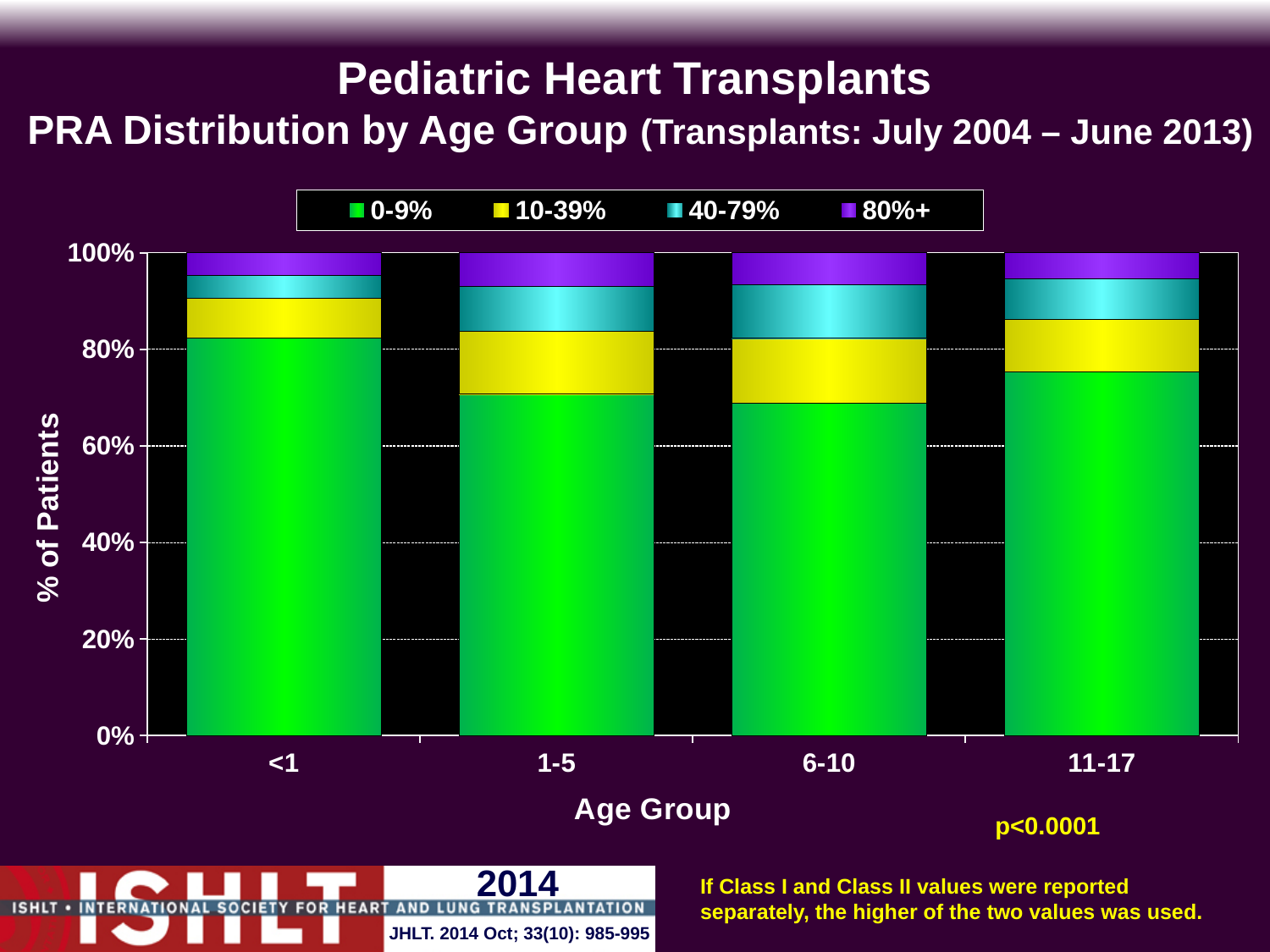
Which age group has a larger 0-9% PRA segment, 11-17 or 6-10? 11-17 Which age group has a larger 0-9% PRA segment, <1 or 6-10? <1 Is the 0-9% PRA share for the 11-17 age group greater or less than 60%? greater What kind of chart is shown on the slide? Stacked bar chart Is the 0-9% PRA share for the 1-5 age group greater or less than 60%? greater What does each stacked bar total? 100% What p-value is shown on the slide? p<0.0001 How many age groups are shown on the x axis? 4 Which age group has the largest 0-9% PRA segment? <1 How many PRA categories does the legend list? 4 Is the 0-9% PRA share for the 6-10 age group greater or less than 80%? less What is the label of the y axis? % of Patients